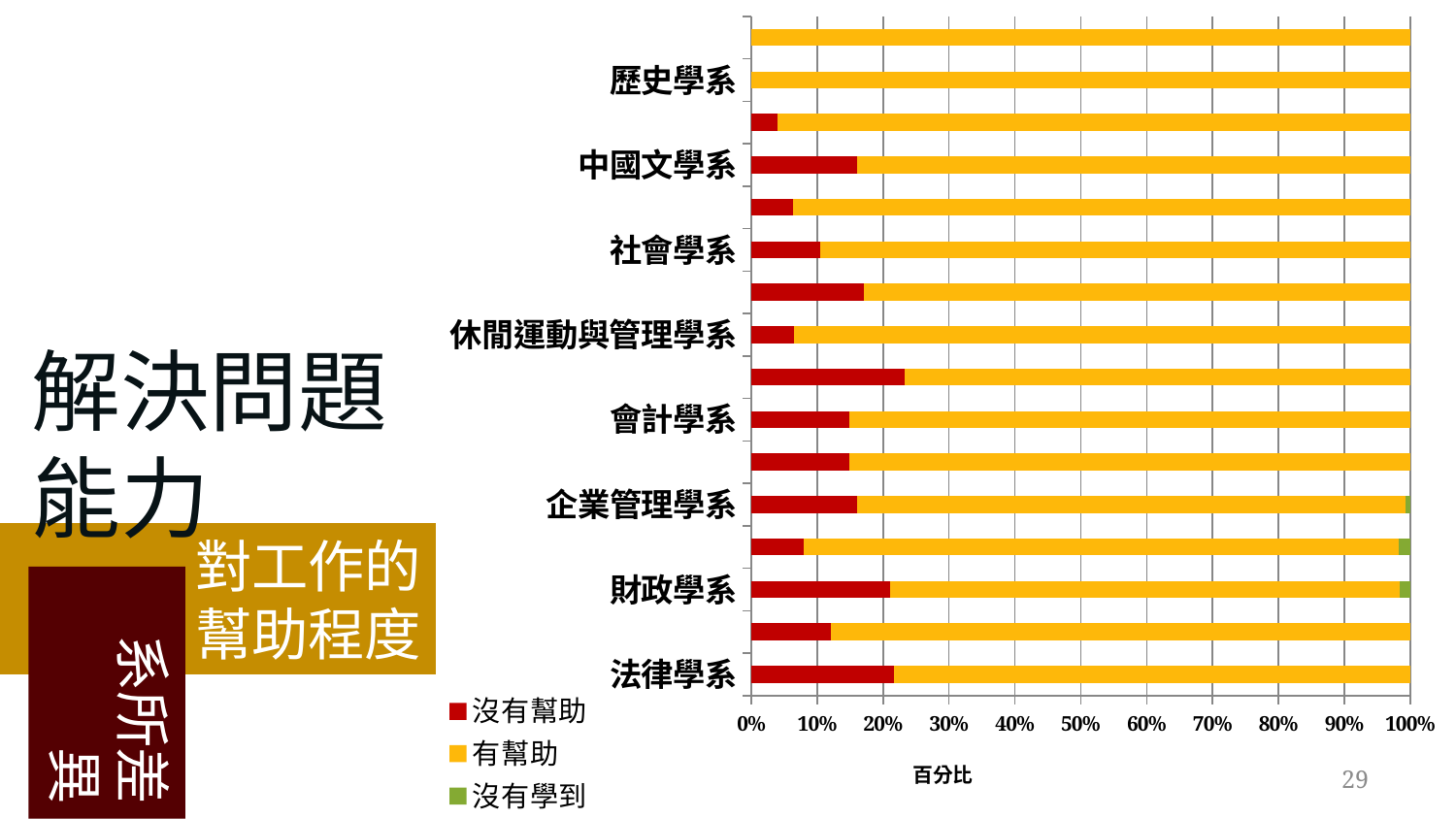
Which legend entry is shown in red? 沒有幫助 What kind of chart is shown on the slide? bar chart What is the title of the horizontal axis? 百分比 Which has the larger 沒有幫助 share, 中國文學系 or 休閒運動與管理學系? 中國文學系 Is the 沒有幫助 value for 法律學系 greater or less than 10%? greater Is the 沒有幫助 value for 會計學系 greater or less than 10%? greater Is the 沒有幫助 value for 中國文學系 greater or less than 20%? less Which has the larger 沒有幫助 share, 法律學系 or 社會學系? 法律學系 Which has the larger 沒有幫助 share, 財政學系 or 歷史學系? 財政學系 How many series does the legend list? 3